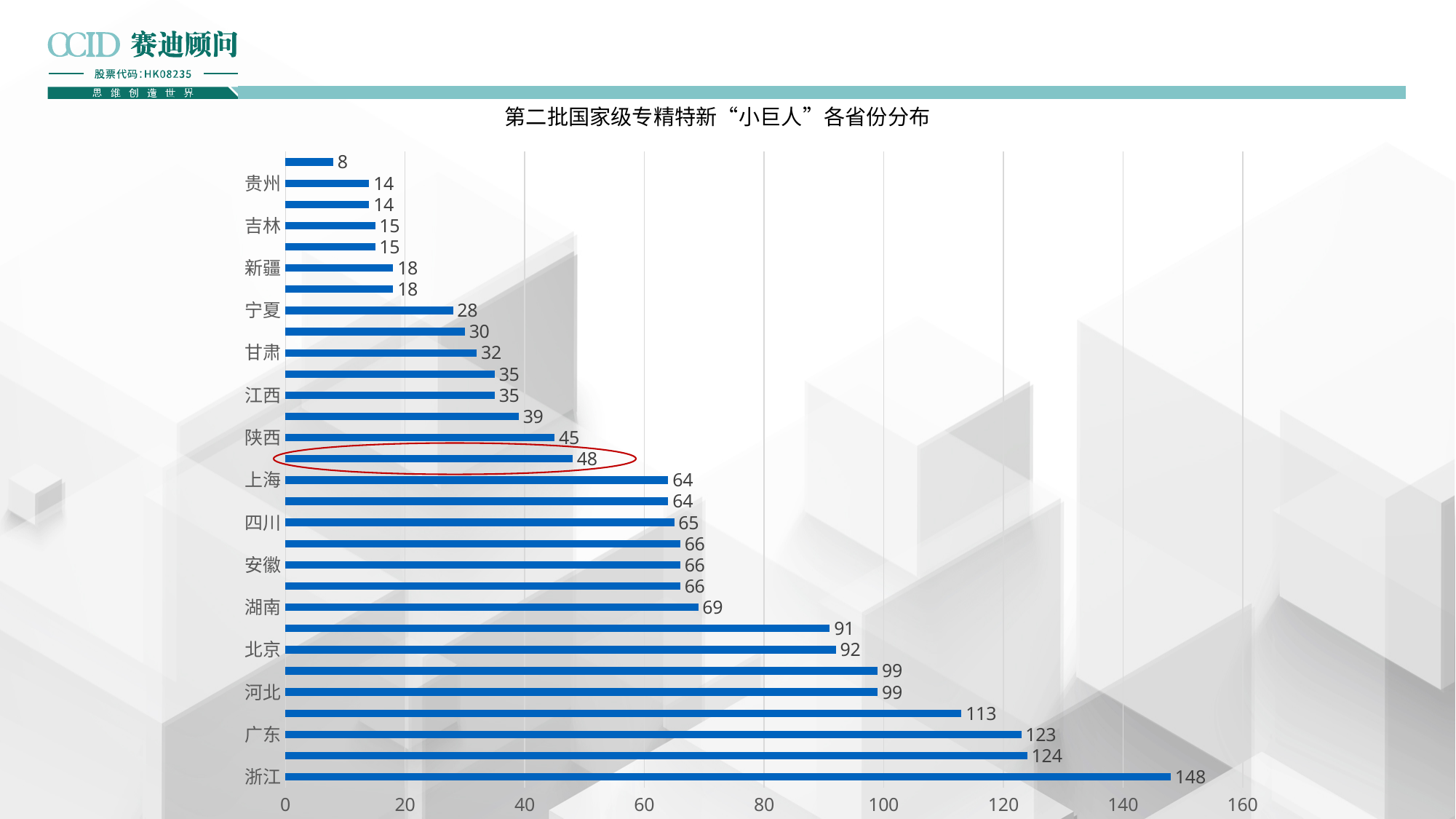
What is the value for 上海? 64 What value is highlighted by the red circle on the chart? 48 What is the smallest value shown on the chart? 8 Which labelled province has the highest value? 浙江 Which has a larger value, 北京 or 河北? 河北 What is the title of the chart? 第二批国家级专精特新“小巨人”各省份分布 How many bars are plotted on the chart? 30 What is the value for 浙江? 148 What is the value for 广东? 123 What is the value for 宁夏? 28 What type of chart is shown on the slide? bar chart What is the difference between the values for 浙江 and 广东? 25